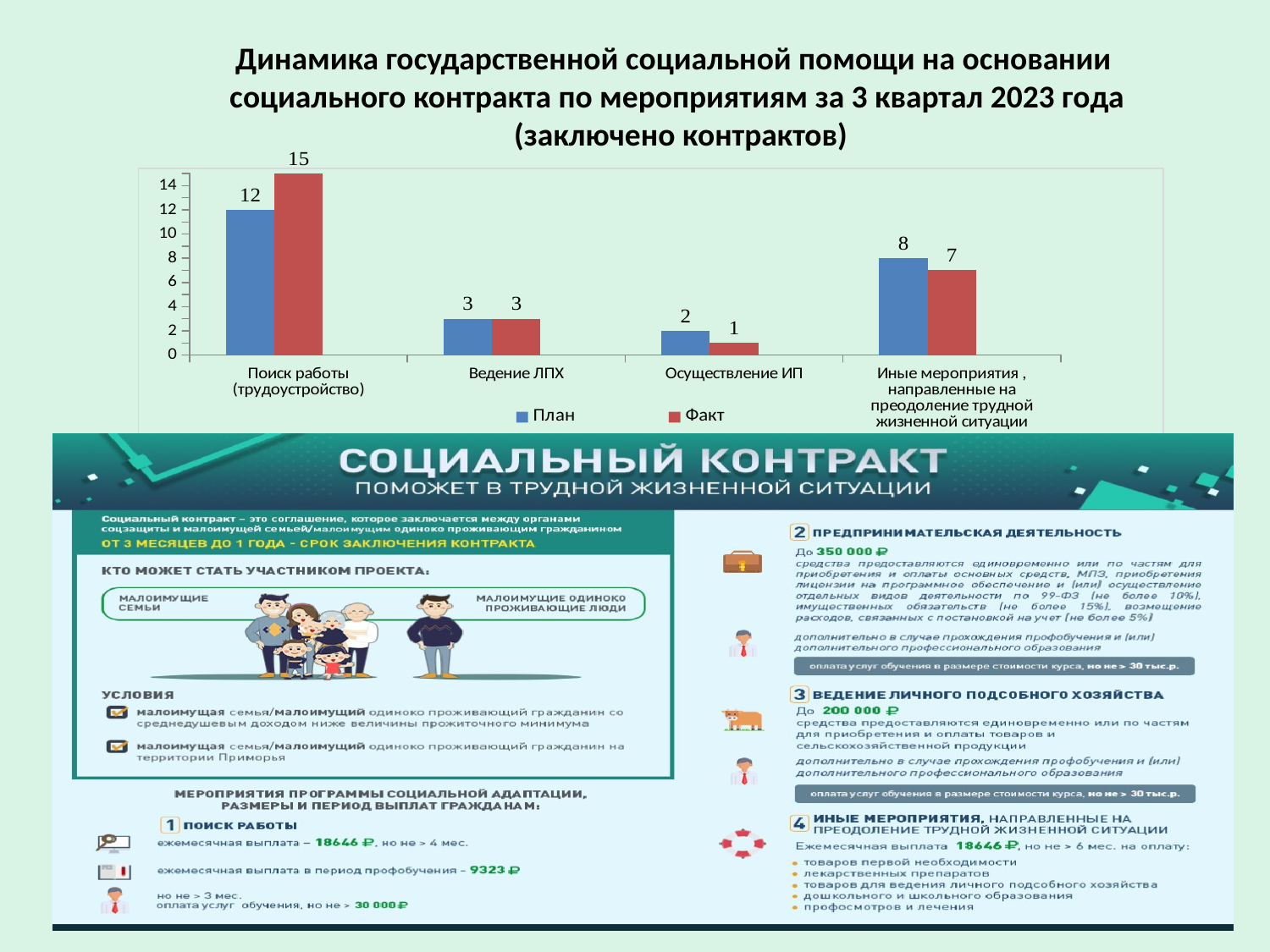
How many series does the legend list? 2 What kind of chart is shown on the slide? Bar chart Which category has the highest Факт value? Поиск работы (трудоустройство) For Иные мероприятия, which is larger: План or Факт? План What is the План value for Поиск работы (трудоустройство)? 12 Which colour represents the Факт series in the chart? Red Which category has the lowest План value? Осуществление ИП How many categories are shown on the x axis? 4 What is the difference between the Факт and План values for Поиск работы (трудоустройство)? 3 What is the Факт value for Поиск работы (трудоустройство)? 15 What is the План value for Иные мероприятия, направленные на преодоление трудной жизненной ситуации? 8 What is the Факт value for Осуществление ИП? 1